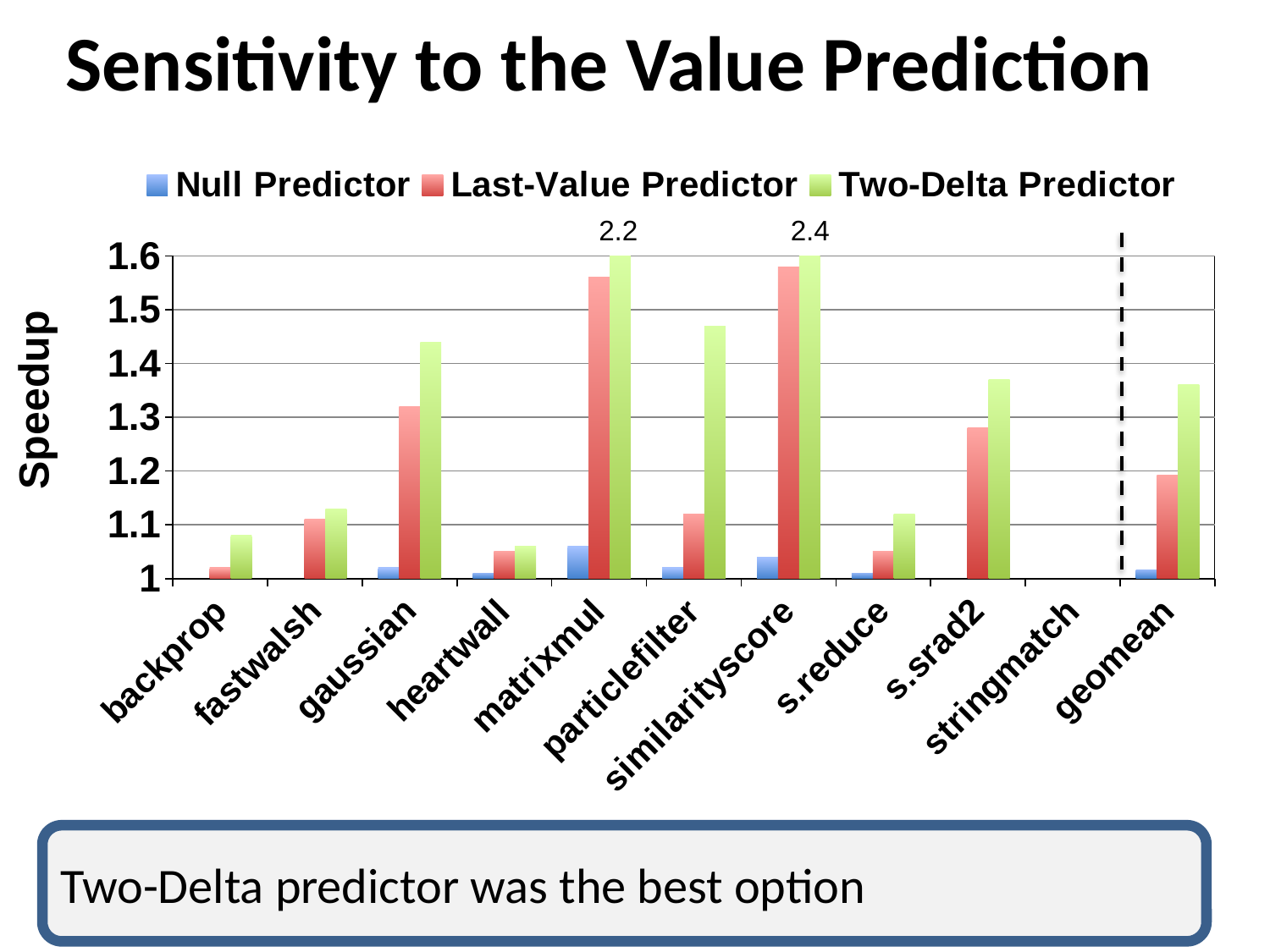
How many series does the legend list? 3 What is the Two-Delta Predictor speedup for matrixmul? 2.2 Which category has the highest Two-Delta Predictor speedup? similarityscore What kind of chart is shown on the slide? bar chart How many categories are shown along the x axis? 11 What is the Two-Delta Predictor speedup for similarityscore? 2.4 Is the Two-Delta Predictor value for gaussian greater or less than 1.3? greater Which series has the highest value for geomean? Two-Delta Predictor Is the Two-Delta Predictor value for fastwalsh greater or less than 1.2? less What is the difference between the Two-Delta Predictor speedups for similarityscore and matrixmul? 0.2 Is the Last-Value Predictor value for s.srad2 greater or less than 1.2? greater What is the label on the y axis? Speedup